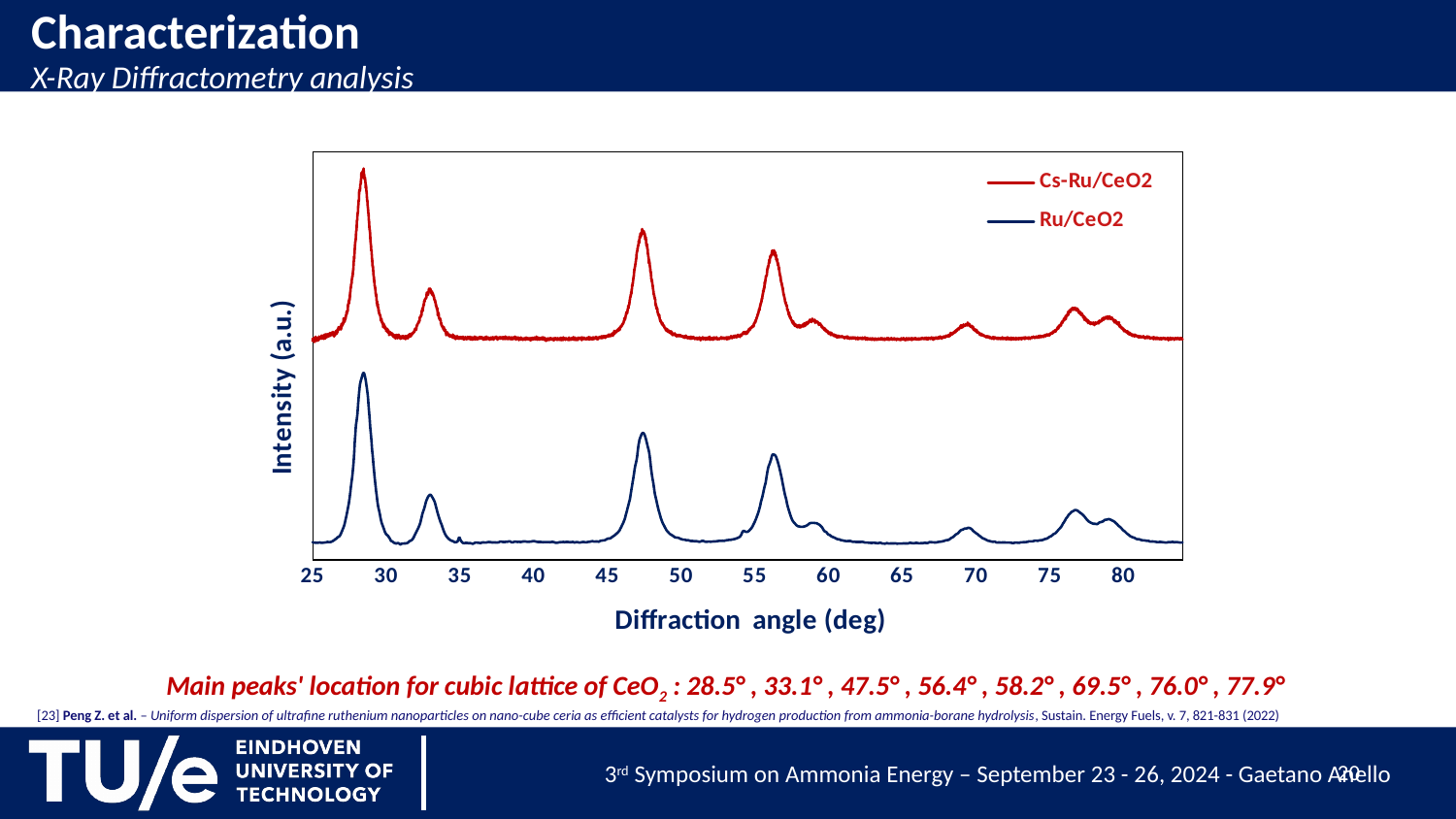
How many series does the legend list? 2 What is the lowest tick label on the x axis? 25 Which series is plotted above the other on the chart, Cs-Ru/CeO2 or Ru/CeO2? Cs-Ru/CeO2 What is the title of the x axis? Diffraction angle (deg) What kind of chart is shown on the slide? line chart Is the diffraction angle of the tallest peak greater or less than 30? less Which series is drawn in red? Cs-Ru/CeO2 Is the diffraction angle of the second-tallest peak greater or less than 45? greater At which diffraction angle does the tallest peak of both series occur, according to the peak locations listed on the slide? 28.5° How many main peak locations for the cubic lattice of CeO2 are listed on the slide? 8 How many tick labels are shown on the x axis? 12